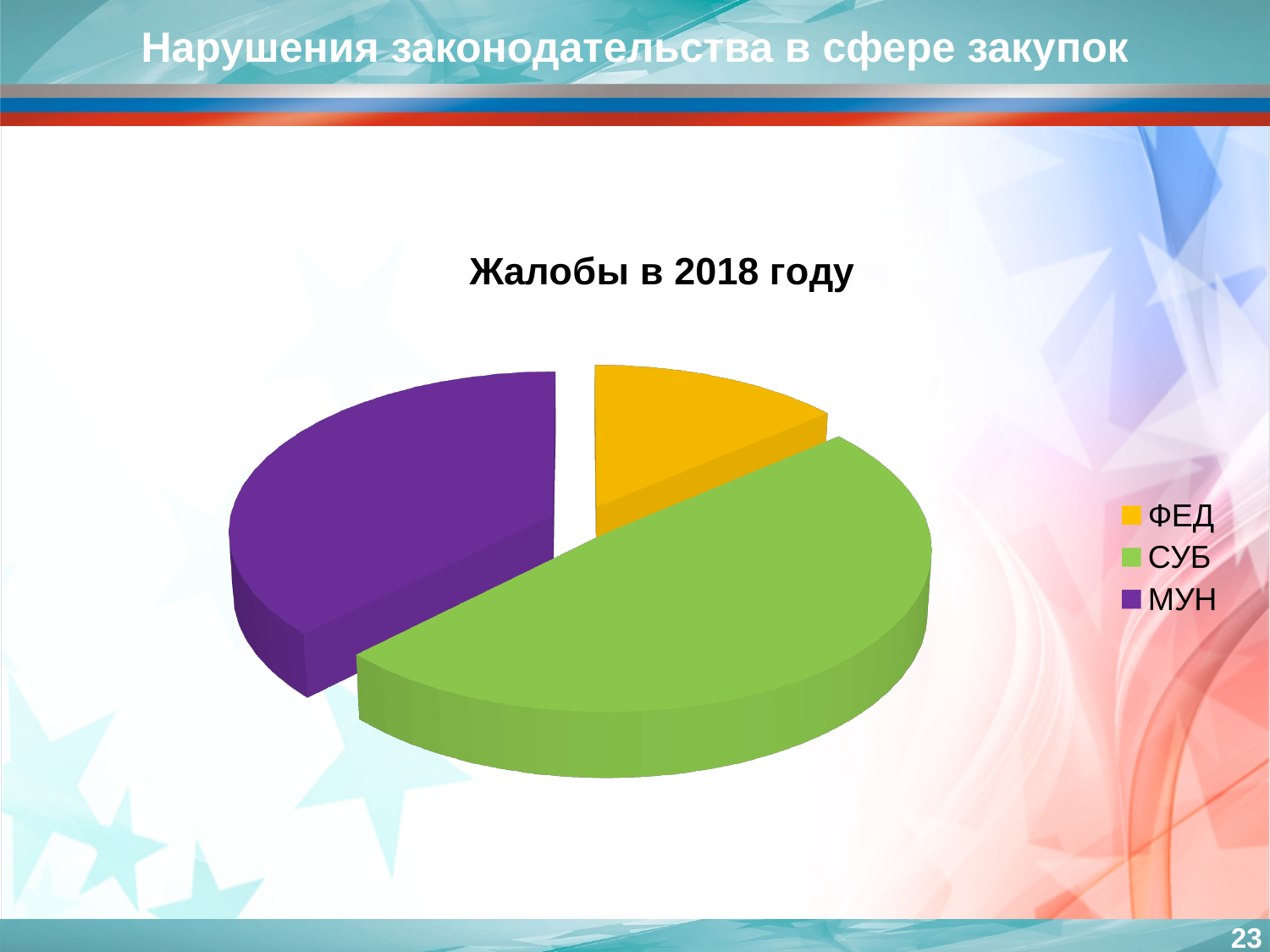
What colour is the slice for МУН? purple Which slice is larger, СУБ or МУН? СУБ How many slices does the pie chart have? 3 How many entries does the legend list? 3 Which category has the largest slice of the pie? СУБ Which category has the smallest slice of the pie? ФЕД Which slice is larger, МУН or ФЕД? МУН Which category is shown in green? СУБ What is the title of the chart? Жалобы в 2018 году What kind of chart is shown on the slide? pie chart